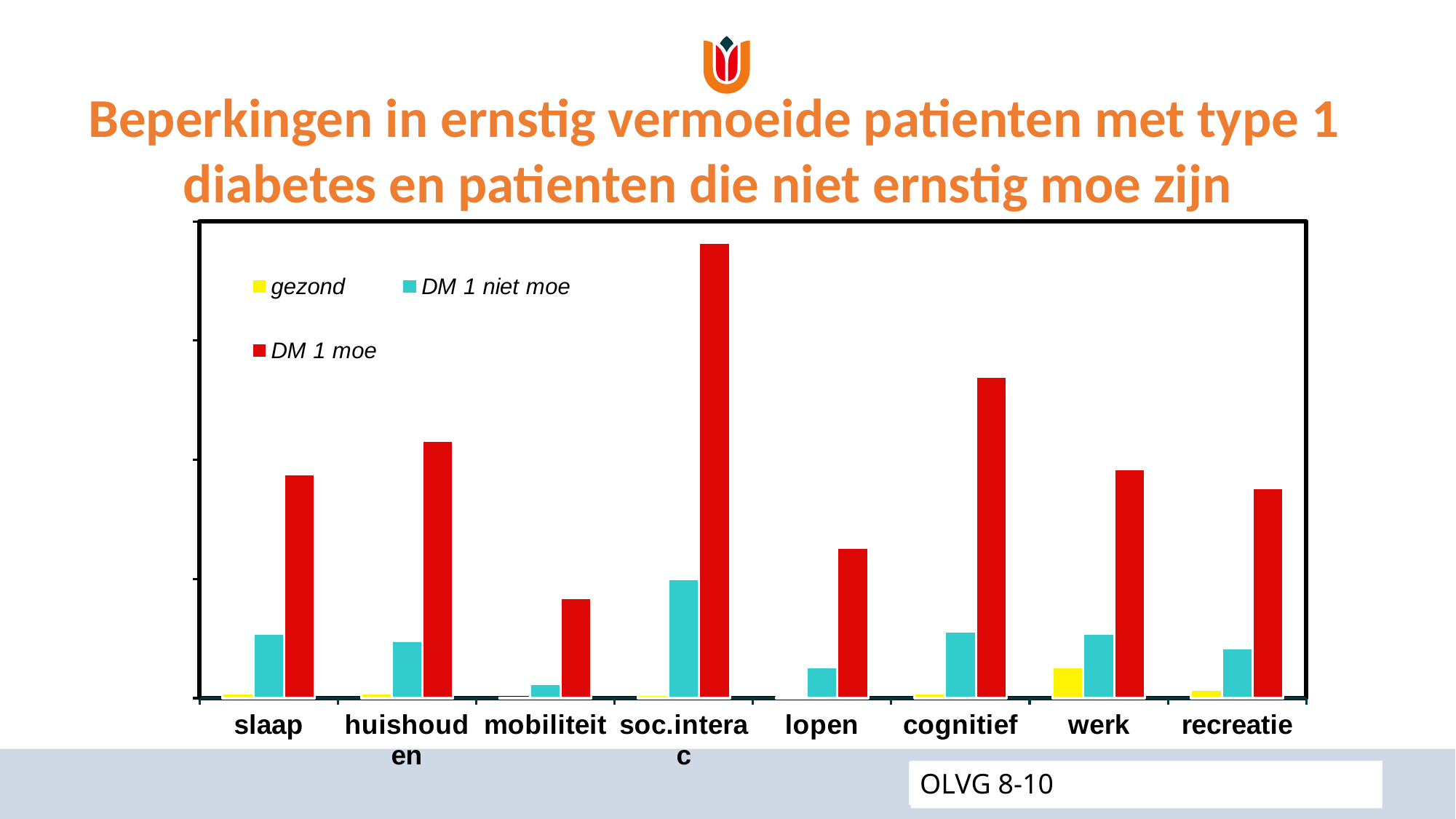
How many series does the legend list? 3 Which series is shown in red? DM 1 moe For which category is the DM 1 moe bar the highest? soc.interac What kind of chart is shown on the slide? bar chart How many categories are shown along the x axis? 8 For which category is the DM 1 moe bar the lowest? mobiliteit Which is larger for DM 1 moe: cognitief or werk? cognitief Which is larger for DM 1 moe: lopen or recreatie? recreatie Which is larger for DM 1 moe: slaap or huishouden? huishouden For which category is the DM 1 niet moe bar the lowest? mobiliteit For which category is the DM 1 niet moe bar the highest? soc.interac For which category is the gezond bar the highest? werk